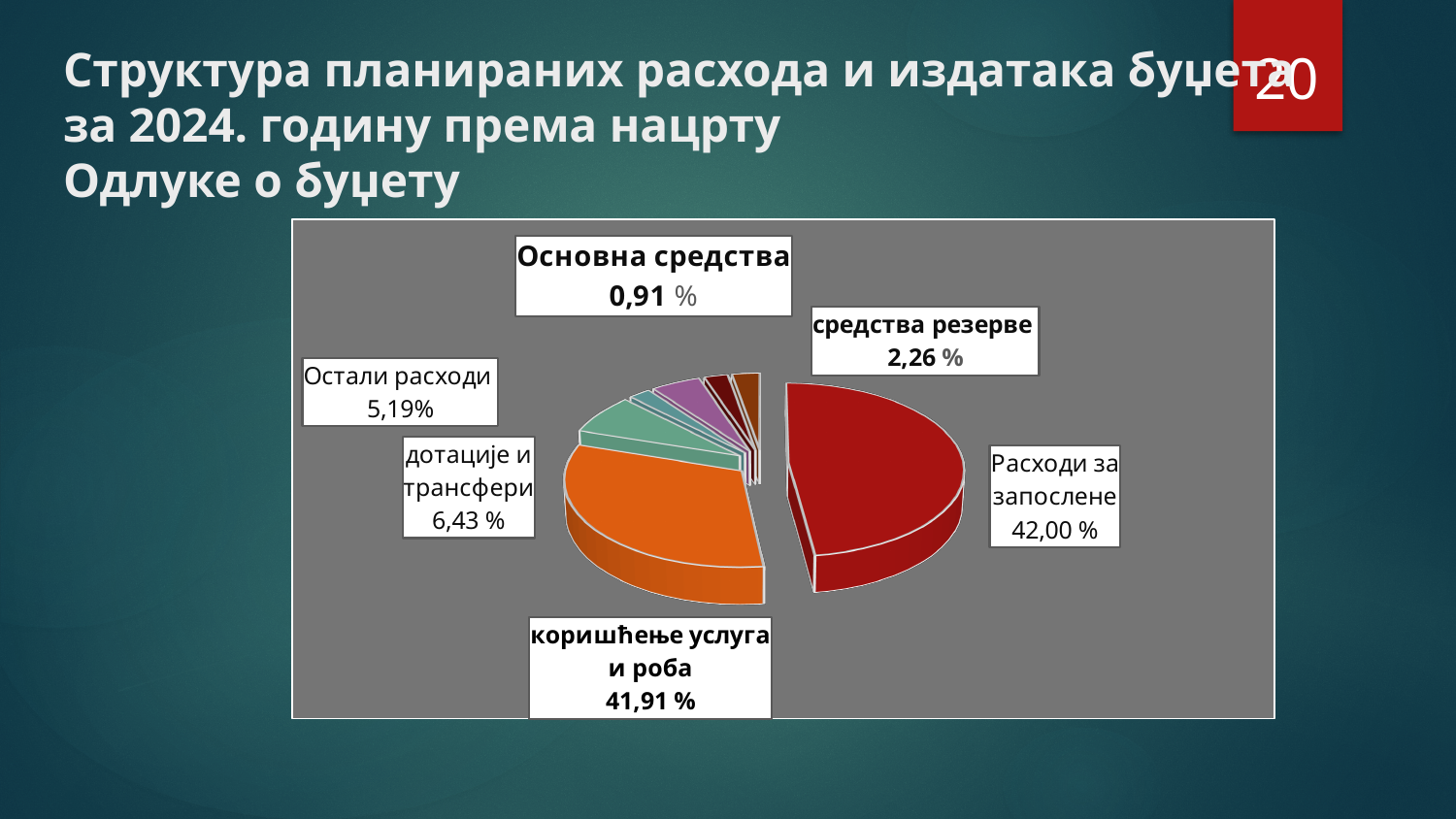
What share of the pie is labelled for коришћење услуга и роба? 41,91 % What share of the pie is labelled for средства резерве? 2,26 % Which has the larger share: дотације и трансфери or Остали расходи? дотације и трансфери What kind of chart is shown on the slide? pie chart What share of the pie is labelled for Основна средства? 0,91 % What is the difference between the shares of Расходи за запослене and коришћење услуга и роба? 0,09 % Which labelled category has the largest share of the pie? Расходи за запослене Which labelled category has the smallest share of the pie? Основна средства What share of the pie is labelled for дотације и трансфери? 6,43 % What is the difference between the shares of средства резерве and Основна средства? 1,35 % What share of the pie is labelled for Остали расходи? 5,19% What share of the pie is labelled for Расходи за запослене? 42,00 %